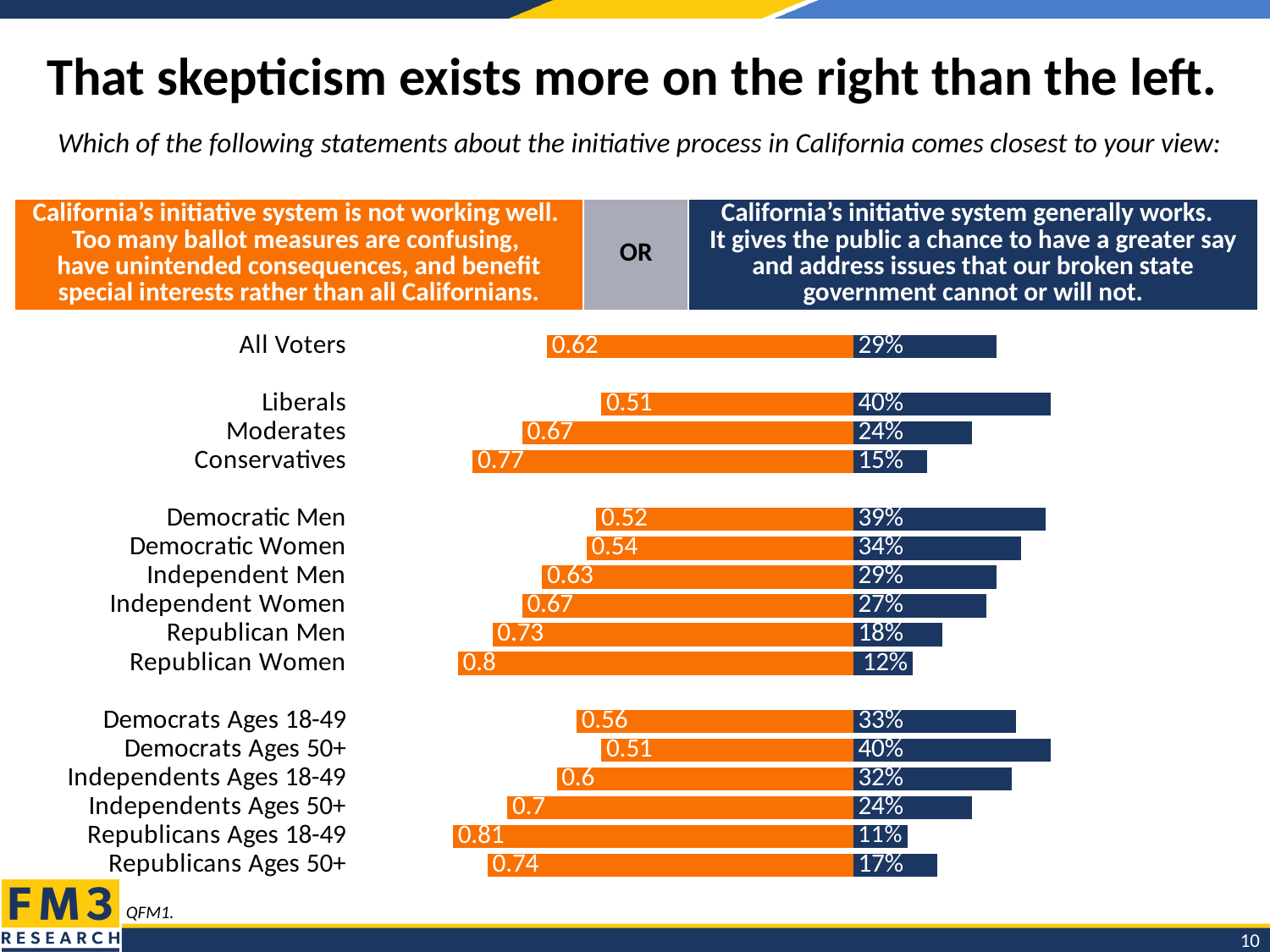
What percentage of Democrats Ages 50+ say the initiative system generally works (navy bar)? 40% Which category has the highest value on the orange 'not working well' bar? Republicans Ages 18-49 What type of chart is shown on the slide? Bar chart Which category has the lowest value on the orange 'not working well' bar? Liberals and Democrats Ages 50+ (both 0.51) What is the value shown on the orange bar for All Voters? 0.62 What is the value shown on the orange bar for Republican Women? 0.8 What is the difference in percentage points between the navy bar for Liberals (40%) and the navy bar for Conservatives (15%)? 25 What percentage of Conservatives say California's initiative system generally works (navy bar)? 15% What colour are the bars representing the statement that California's initiative system is not working well? Orange How many categories (rows) are plotted in the chart? 16 Which category has the lowest percentage on the navy 'generally works' bar? Republicans Ages 18-49 Which has a larger orange bar value, Democratic Men or Republican Men? Republican Men